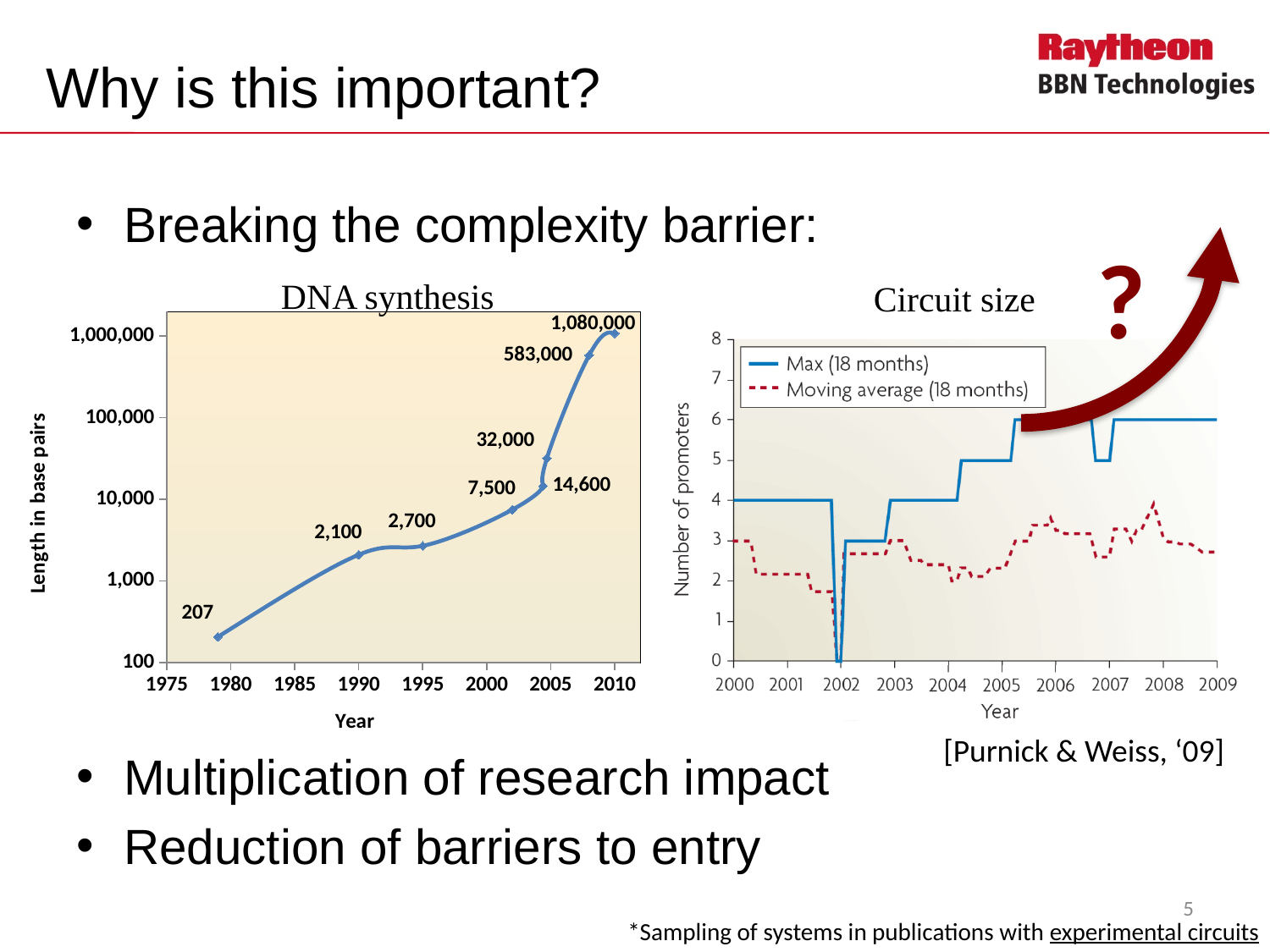
In the DNA synthesis chart, what is the difference between the two highest labeled values, 1,080,000 and 583,000? 497,000 In the DNA synthesis chart, do the values rise or fall as the year increases? Rise What kind of chart is the DNA synthesis chart on the left? Line chart In the DNA synthesis chart, what is the lowest labeled length in base pairs? 207 In the Circuit size chart, what is the value of the Max (18 months) series in 2008? 6 In the Circuit size chart, what is the value of the Max (18 months) series in 2001? 4 What is the y-axis label of the DNA synthesis chart? Length in base pairs In the DNA synthesis chart, how many data points carry a printed value label? 8 In the DNA synthesis chart, what is the highest labeled length in base pairs? 1,080,000 In the Circuit size chart, which series has the larger value in 2008, Max (18 months) or Moving average (18 months)? Max (18 months) How many series does the legend of the Circuit size chart list? 2